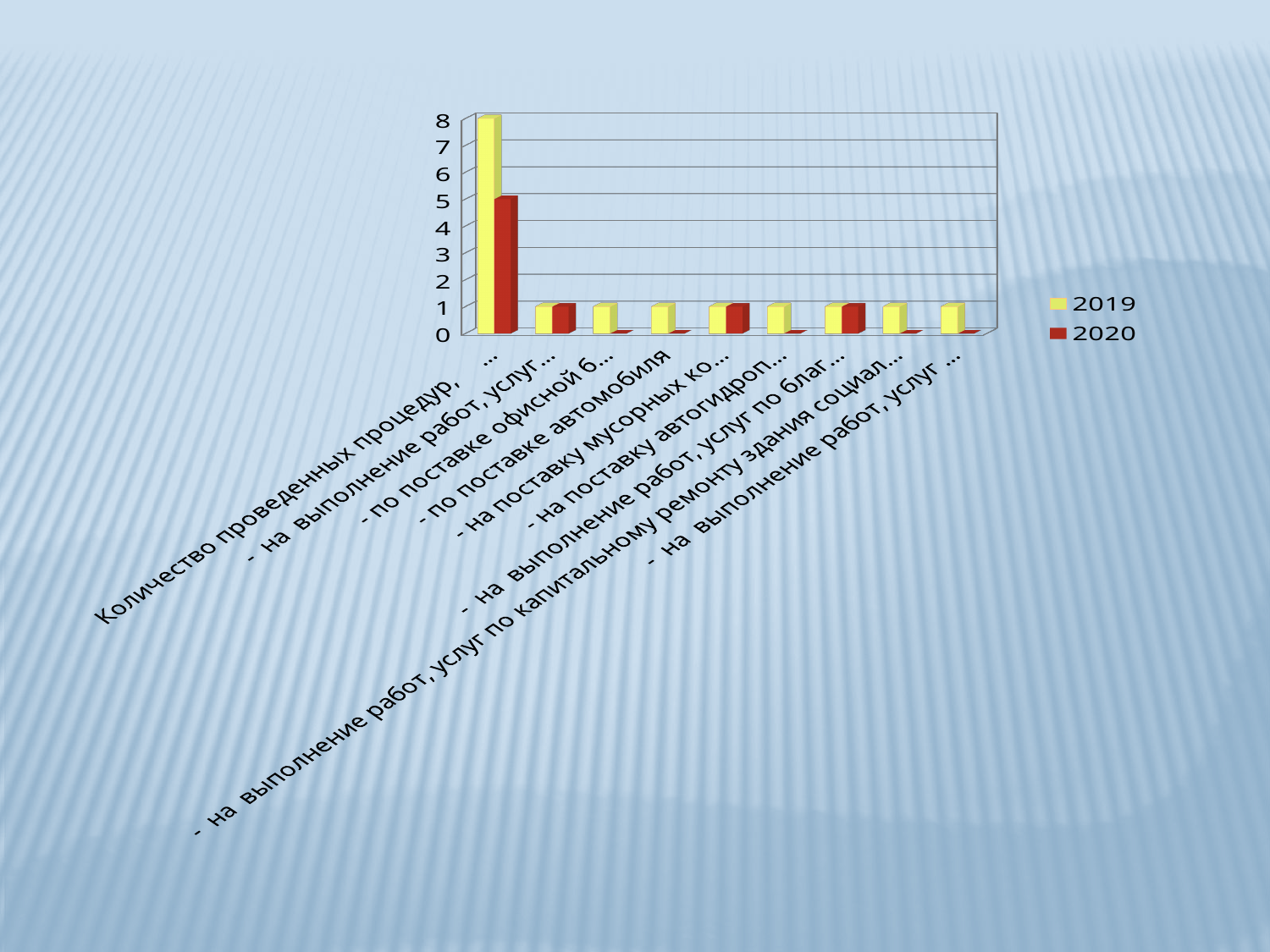
How many series does the legend list? 2 How many categories are shown on the x axis? 9 For "Количество проведенных процедур", which series has the larger value, 2019 or 2020? 2019 Which category has the highest 2019 value? Количество проведенных процедур What is the difference between the 2019 and 2020 values for "Количество проведенных процедур"? 3 What is the 2019 value for the category "Количество проведенных процедур"? 8 What colour are the bars for the 2020 series? red What is the 2019 value for the category "по поставке автомобиля"? 1 What is the 2020 value for the category "по поставке автомобиля"? 0 What kind of chart is shown on the slide? bar chart What are the series listed in the legend? 2019 and 2020 What is the 2020 value for the category "Количество проведенных процедур"? 5